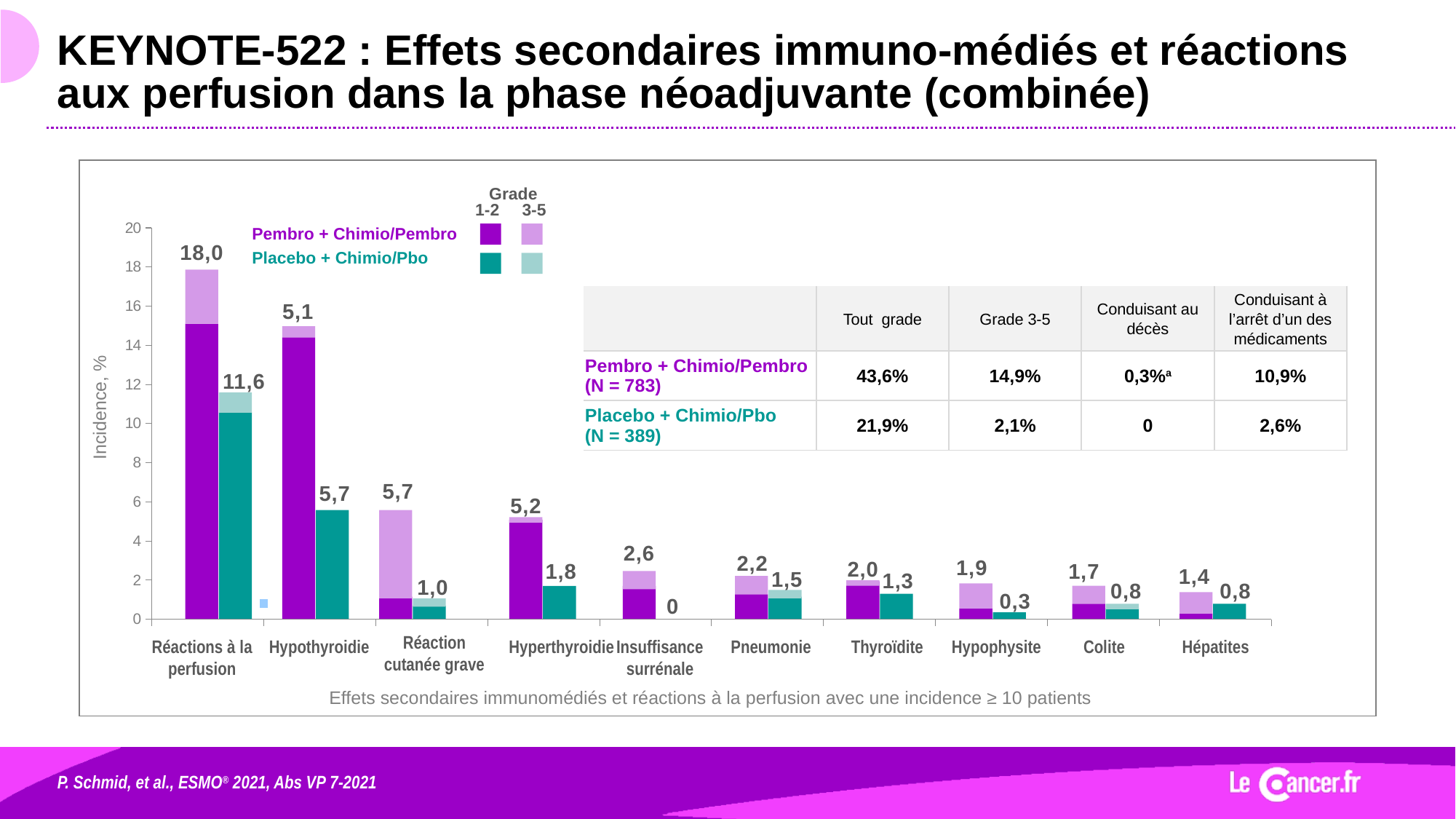
What type of chart is used to show the incidence of adverse events? Bar chart What is the incidence of Insuffisance surrénale for Placebo + Chimio/Pbo? 0 How many adverse event categories are shown on the x axis of the chart? 10 Which category has the highest incidence for Pembro + Chimio/Pembro? Réactions à la perfusion Is the Placebo + Chimio/Pbo value for Réactions à la perfusion greater or less than 10? greater Which category has the lowest incidence for Pembro + Chimio/Pembro? Hépatites What is the label of the y axis of the chart? Incidence, % What is the incidence of Hypothyroidie for Placebo + Chimio/Pbo? 5,7 What is the difference between the Pembro + Chimio/Pembro and Placebo + Chimio/Pbo incidence for Réactions à la perfusion? 6,4 For Hypothyroidie, which arm has the higher incidence, Pembro + Chimio/Pembro or Placebo + Chimio/Pbo? Placebo + Chimio/Pbo Which two grade groups does the chart legend distinguish? Grade 1-2 and Grade 3-5 What is the incidence of Réactions à la perfusion for Pembro + Chimio/Pembro? 18,0